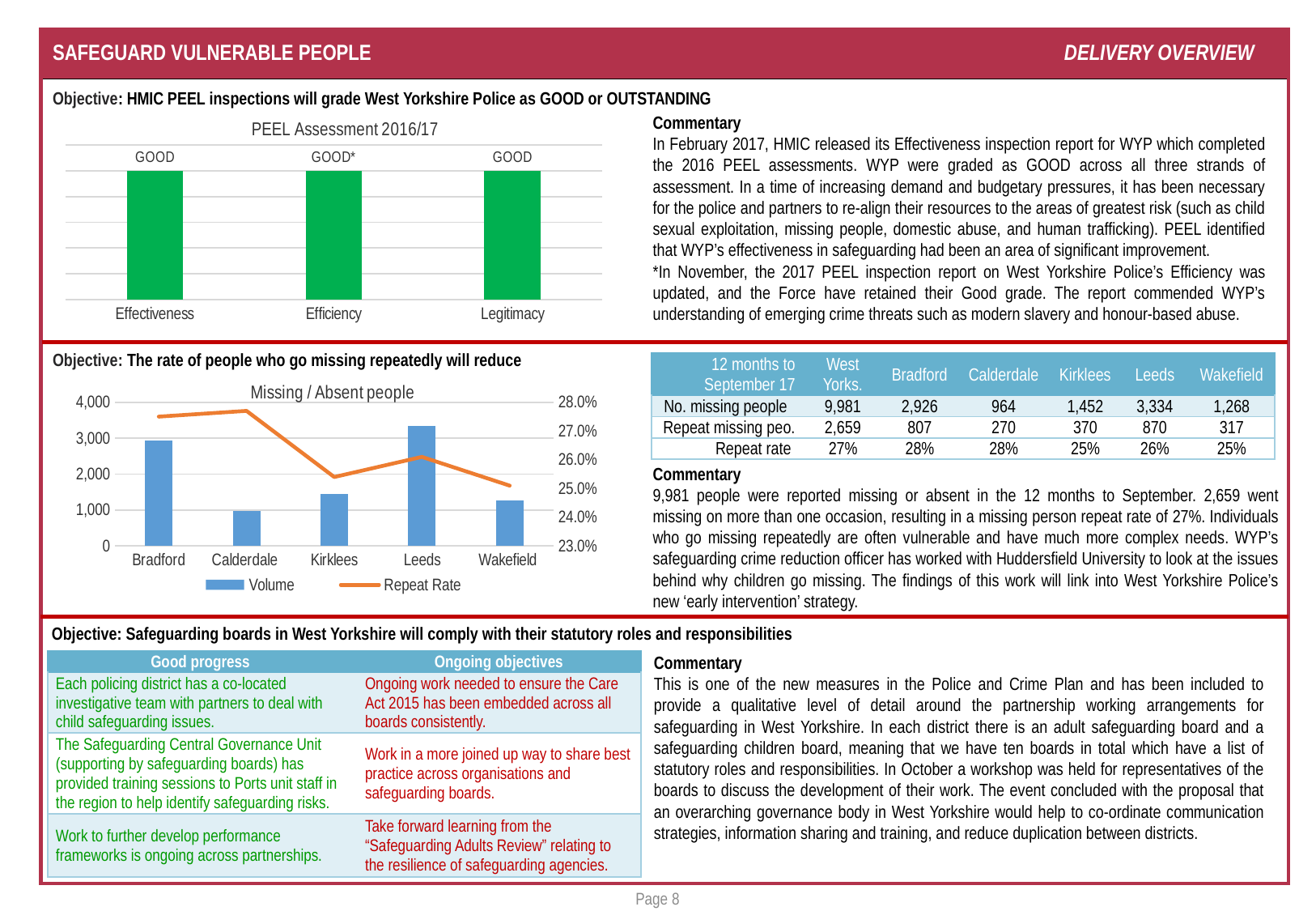
What type of chart is the PEEL Assessment 2016/17 chart? bar chart On the Missing / Absent people chart, is the Volume for Calderdale greater or less than 1,000? less On the Missing / Absent people chart, which district has the highest Volume? Leeds On the PEEL Assessment 2016/17 chart, what label appears above the Efficiency bar? GOOD* On the Missing / Absent people chart, is the Repeat Rate for Wakefield higher or lower than for Bradford? lower On the Missing / Absent people chart, is the Repeat Rate for Kirklees greater or less than 26.0%? less On the Missing / Absent people chart, is the Volume for Bradford greater or less than 2,000? greater On the Missing / Absent people chart, which has the larger Volume, Leeds or Bradford? Leeds How many categories are shown on the PEEL Assessment 2016/17 chart? 3 How many series does the legend of the Missing / Absent people chart list? 2 What is the title of the chart in the middle-left section of the slide? Missing / Absent people On the Missing / Absent people chart, which district has the lowest Volume? Calderdale